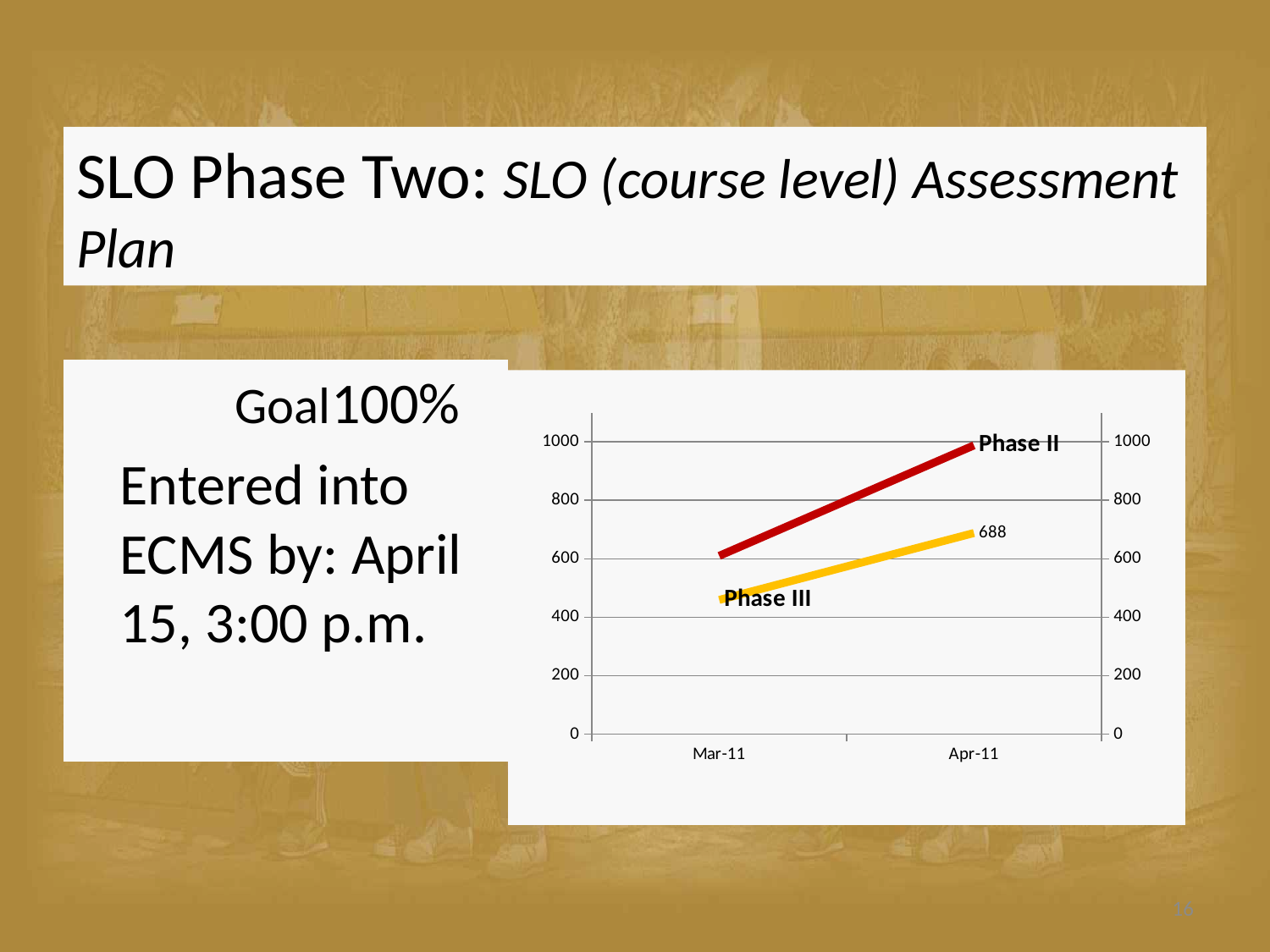
Does the Phase II line rise or fall from Mar-11 to Apr-11? rise Is the value for Phase II at Apr-11 greater or less than 800? greater What colour is the Phase II line? red Does the Phase III line rise or fall from Mar-11 to Apr-11? rise How many lines are plotted on the chart? 2 Which line is higher at Apr-11, Phase II or Phase III? Phase II What is the value of Phase III at Apr-11? 688 What kind of chart is shown on the slide? line chart Which series has the highest value at Mar-11? Phase II How many points are on the x axis of the chart? 2 Is the value for Phase II at Mar-11 greater or less than 800? less Is the value for Phase III at Mar-11 greater or less than 600? less